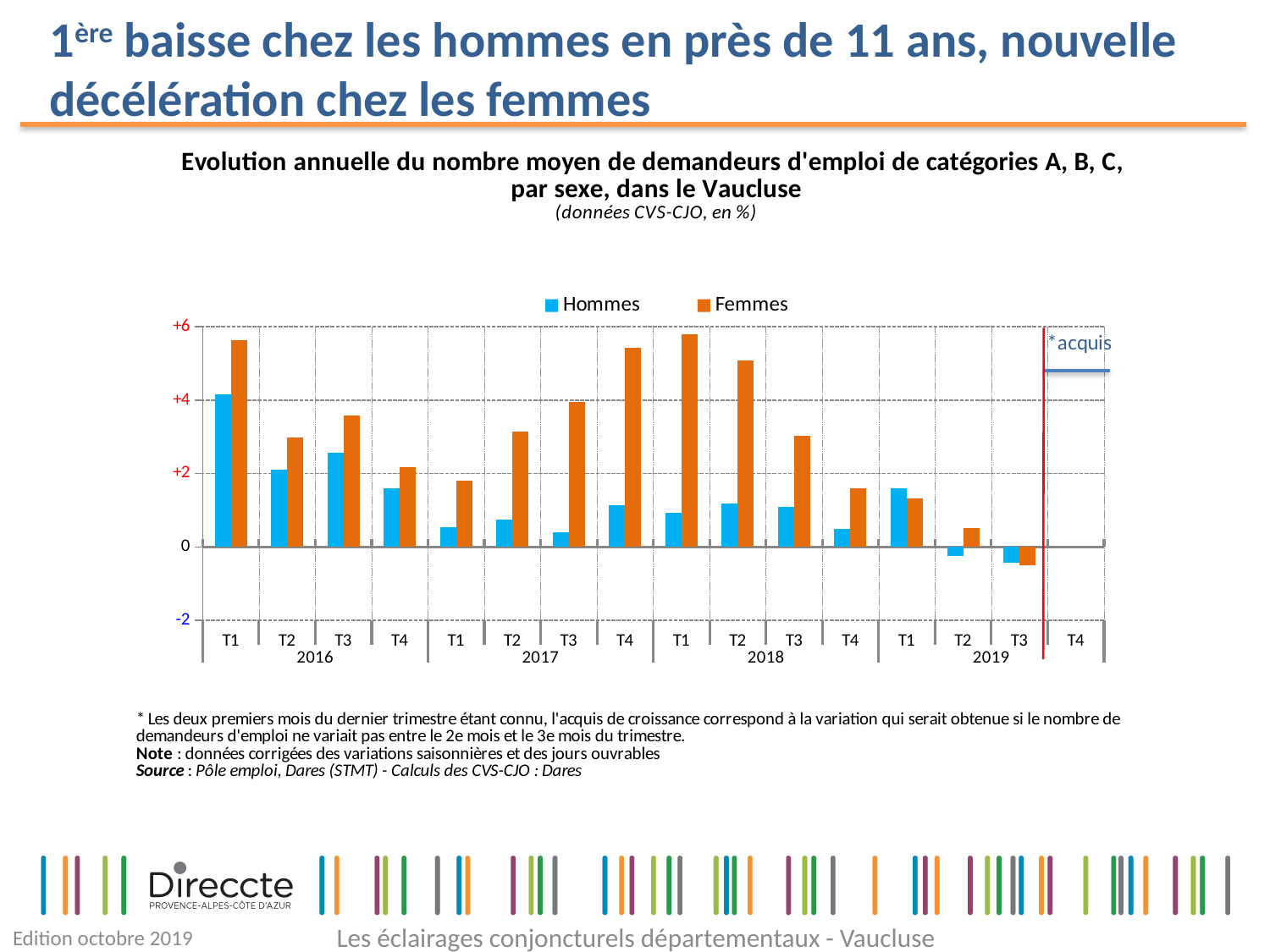
Is the Hommes value for T3 2017 greater or less than +2? less How many quarters (T1–T4 labels) are shown along the x axis? 16 Is the Femmes value for T4 2017 greater or less than +4? greater In which quarter is the Hommes value the lowest? T3 2019 In which quarter is the Hommes value the highest? T1 2016 Which series is shown in orange in the legend? Femmes How many series does the legend list? 2 In T1 2019, which is larger, the Hommes value or the Femmes value? Hommes In T3 2017, which is larger, the Hommes value or the Femmes value? Femmes What kind of chart is shown on the slide? bar chart Is the Femmes value for T1 2016 greater or less than +4? greater Do the Hommes values rise or fall from T1 2019 to T3 2019? fall